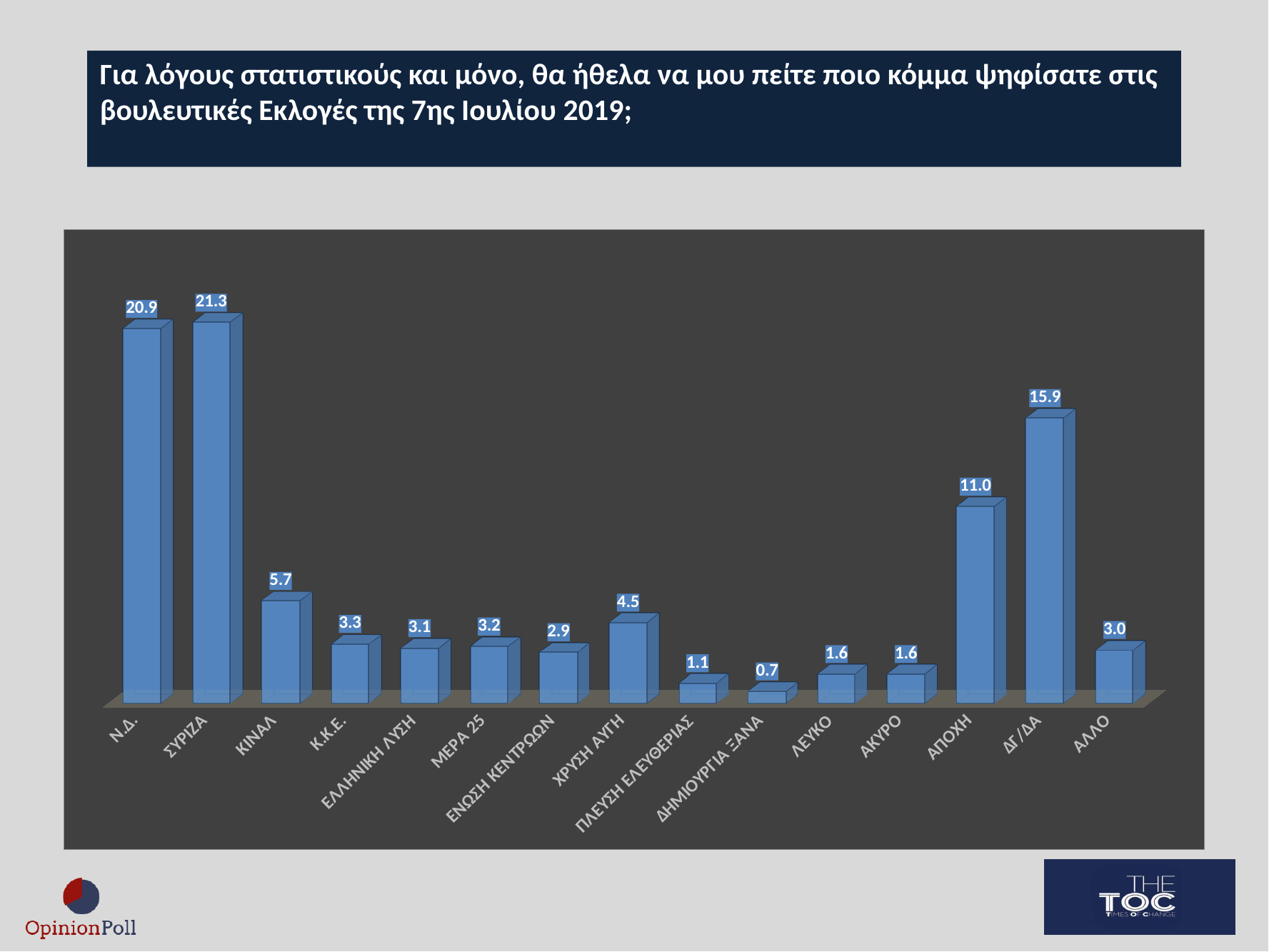
What value is shown for ΑΠΟΧΗ? 11.0 How many categories are shown on the x axis? 15 What is the difference between the values for ΣΥΡΙΖΑ and Ν.Δ.? 0.4 What kind of chart is shown on the slide? Bar chart Which category has the lowest value? ΔΗΜΙΟΥΡΓΙΑ ΞΑΝΑ What value is shown for ΧΡΥΣΗ ΑΥΓΗ? 4.5 Which category has the highest value? ΣΥΡΙΖΑ What value is shown for ΔΓ/ΔΑ? 15.9 Which is larger, the value for ΚΙΝΑΛ or the value for ΧΡΥΣΗ ΑΥΓΗ? ΚΙΝΑΛ What is the difference between the values for ΔΓ/ΔΑ and ΑΠΟΧΗ? 4.9 Which two categories share the same value of 1.6? ΛΕΥΚΟ and ΑΚΥΡΟ What value is shown for ΣΥΡΙΖΑ? 21.3